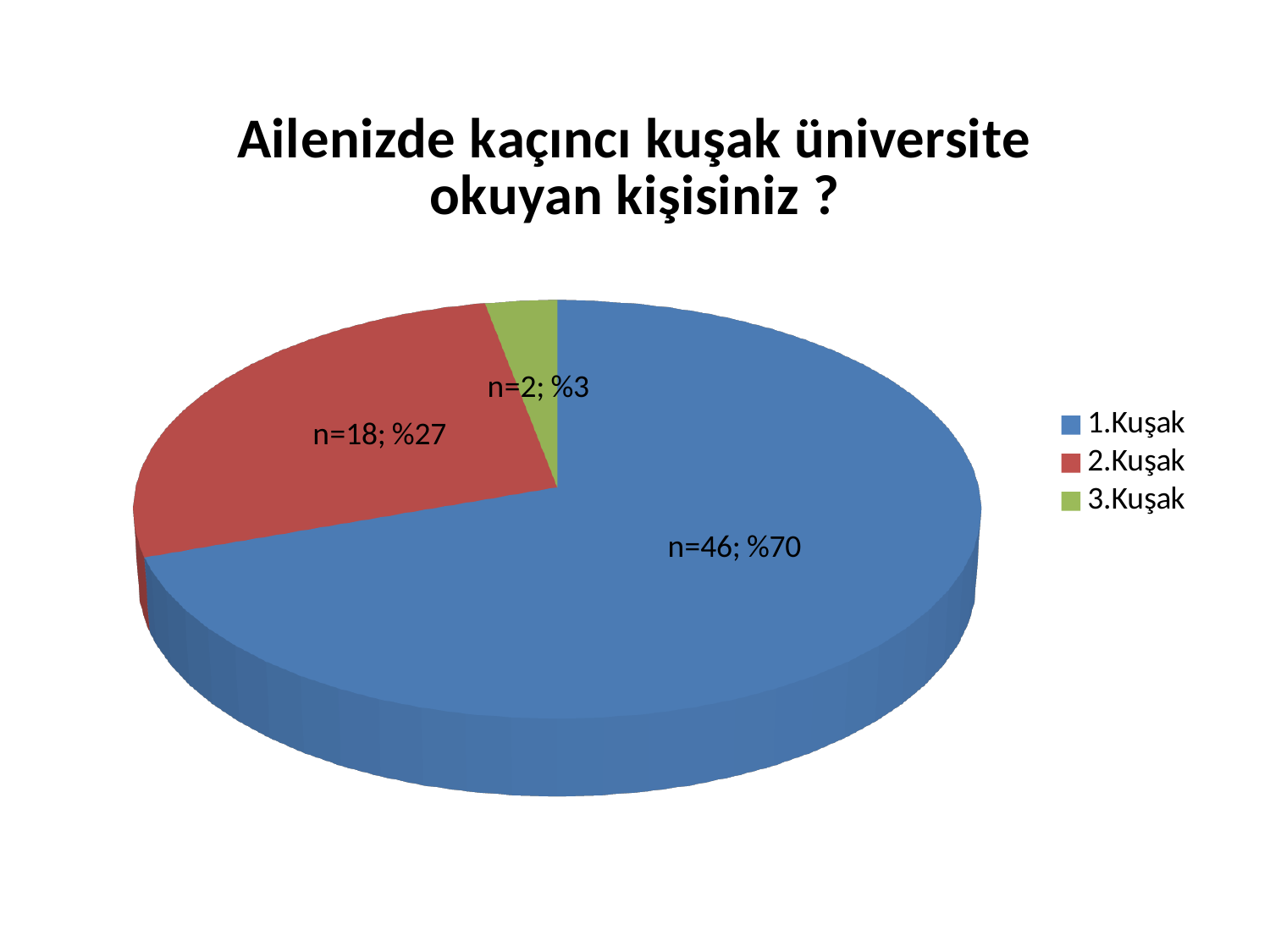
What is the count (n) for 1.Kuşak? n=46 What colour is the slice for 3.Kuşak? green How many entries does the legend list? 3 Which category has the largest slice? 1.Kuşak What percentage share does 2.Kuşak have? %27 What is the count (n) for 3.Kuşak? n=2 Which is larger, the count for 2.Kuşak or the count for 3.Kuşak? 2.Kuşak What is the difference in count between 1.Kuşak and 2.Kuşak? 28 What is the title of the chart? Ailenizde kaçıncı kuşak üniversite okuyan kişisiniz ? Which category has the smallest slice? 3.Kuşak How many slices does the pie chart have? 3 What kind of chart is shown on the slide? pie chart